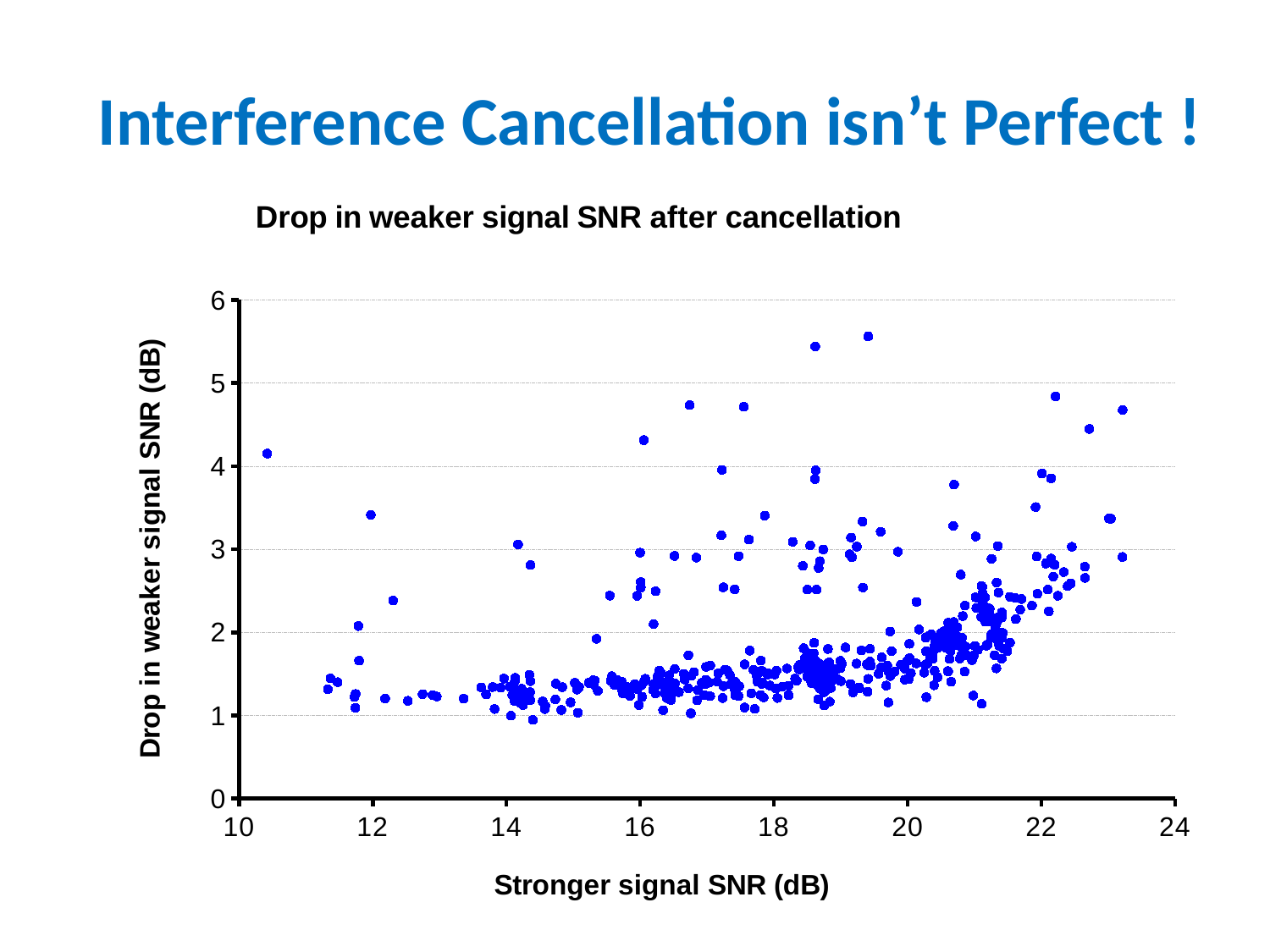
What kind of chart is shown on the slide? Scatter chart Does the dense band of points generally rise or fall as the stronger signal SNR increases from 14 to 22 dB? rise What is the lowest value shown on the horizontal axis? 10 What is the label of the horizontal axis? Stronger signal SNR (dB) Is the leftmost plotted point (near 10 dB stronger signal SNR) greater or less than 4 dB? greater Are any plotted points above 6 dB on the vertical axis? No Is the highest plotted point greater or less than 5 dB? greater What is the title of the chart? Drop in weaker signal SNR after cancellation What is the highest value shown on the vertical axis? 6